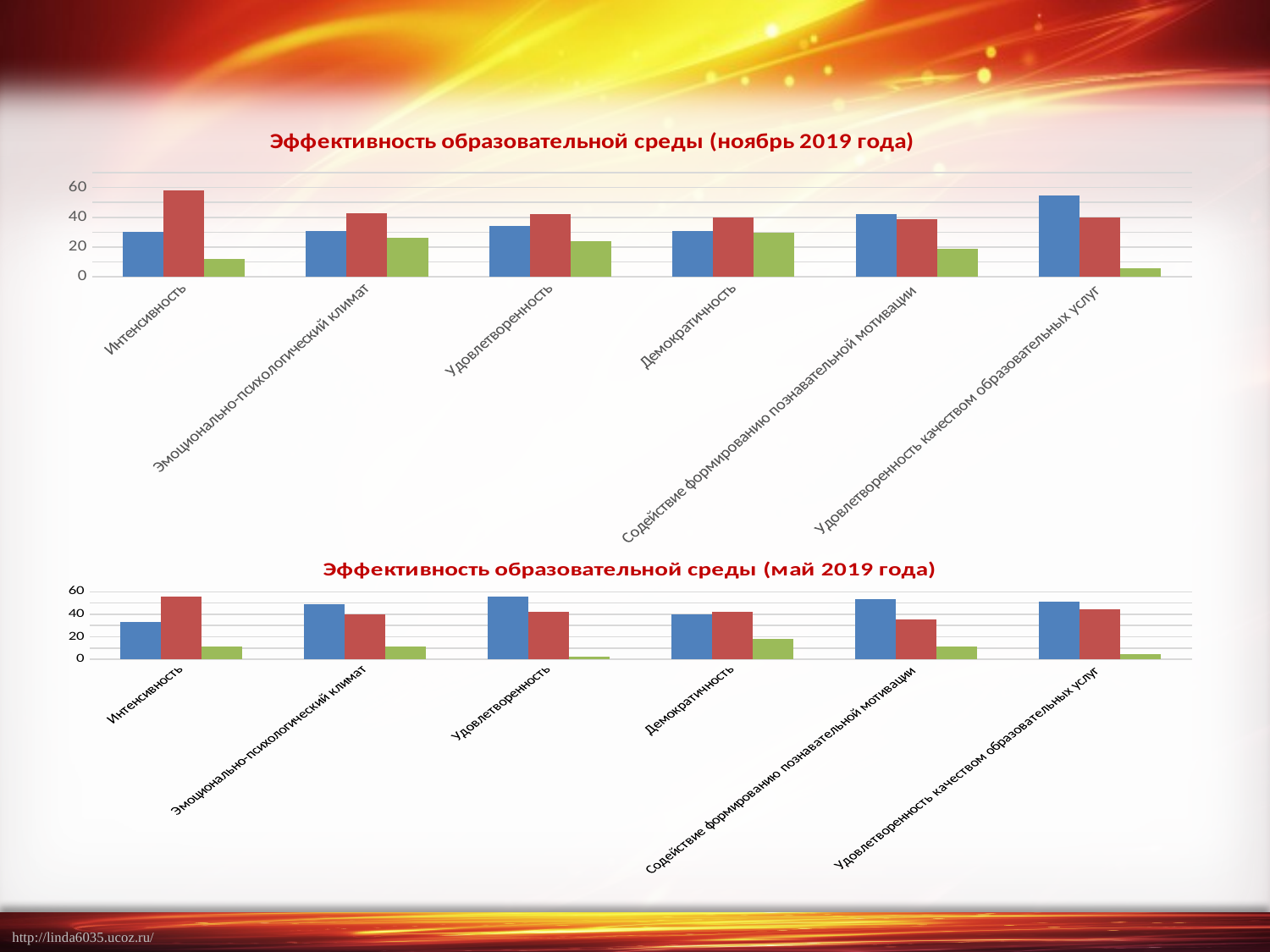
What kind of chart is the top chart, 'Эффективность образовательной среды (ноябрь 2019 года)'? bar chart In the top chart (ноябрь 2019 года), for Интенсивность, which is larger: the blue bar or the red bar? the red bar In the top chart (ноябрь 2019 года), which category has the tallest blue bar? Удовлетворенность качеством образовательных услуг In the top chart (ноябрь 2019 года), is the value of the green bar for Удовлетворенность качеством образовательных услуг greater or less than 20? less In the top chart (ноябрь 2019 года), which category has the shortest green bar? Удовлетворенность качеством образовательных услуг How many categories are shown on the x axis of the bottom chart (май 2019 года)? 6 In the bottom chart (май 2019 года), for Содействие формированию познавательной мотивации, which is larger: the blue bar or the red bar? the blue bar In the top chart (ноябрь 2019 года), is the value of the red bar for Интенсивность greater or less than 40? greater How many charts are shown on the slide? 2 How many categories are shown on the x axis of the top chart (ноябрь 2019 года)? 6 In the bottom chart (май 2019 года), is the value of the blue bar for Удовлетворенность greater or less than 40? greater What is the title of the bottom chart on the slide? Эффективность образовательной среды (май 2019 года)